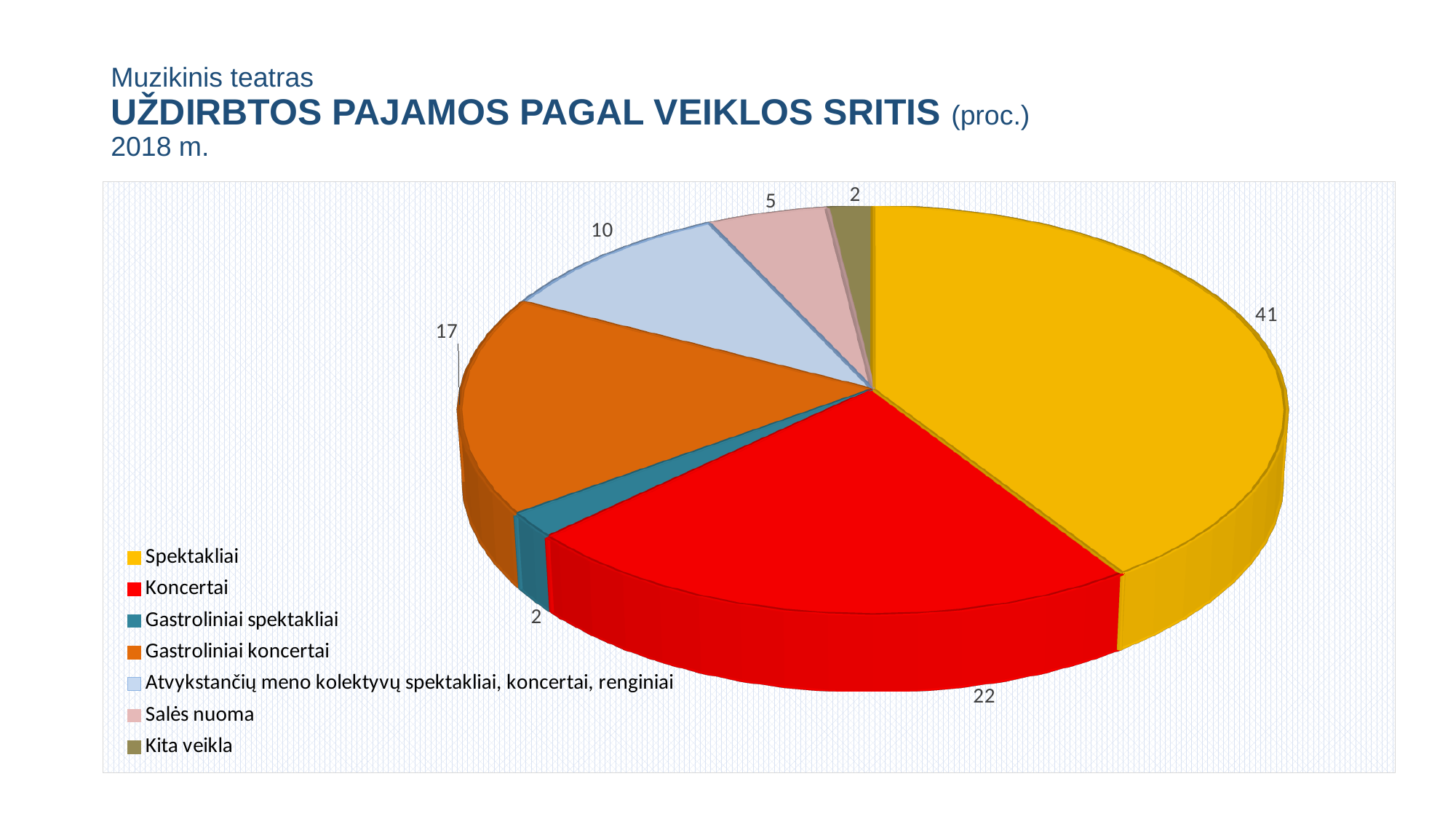
What is the value shown for Salės nuoma? 5 What is the value shown for Atvykstančių meno kolektyvų spektakliai, koncertai, renginiai? 10 What is the difference between the values for Koncertai and Gastroliniai koncertai? 5 What is the value shown for Gastroliniai koncertai? 17 What type of chart is shown on the slide? pie chart What is the difference between the values for Spektakliai and Koncertai? 19 How many categories does the legend list? 7 What is the value shown for Koncertai? 22 Which year does the chart title refer to? 2018 m. Which category has the largest slice of the pie? Spektakliai Which is larger, the value for Gastroliniai koncertai or the value for Salės nuoma? Gastroliniai koncertai What is the value shown for Spektakliai? 41